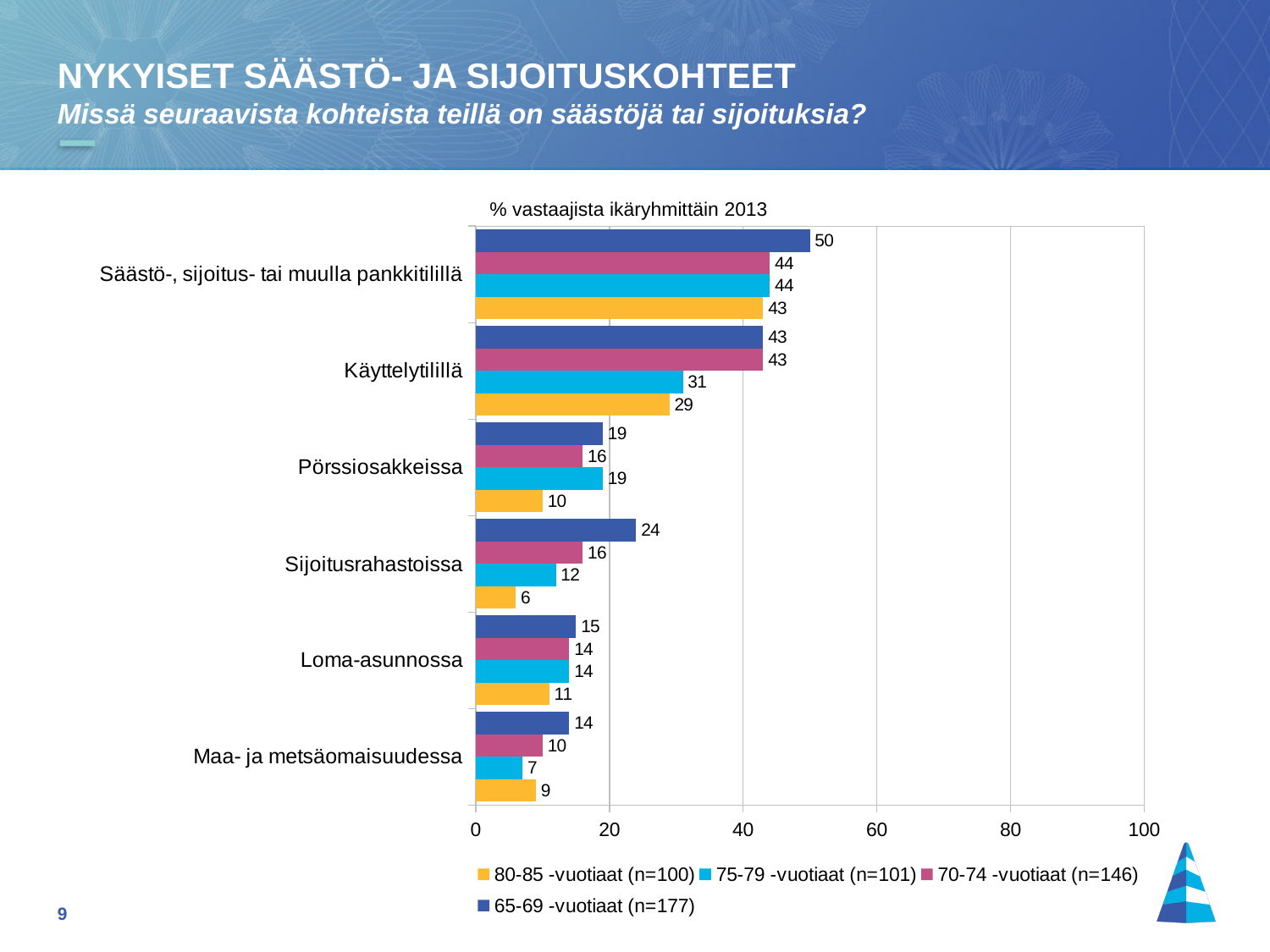
In the category Käyttelytilillä, which is larger: the value for 75-79 -vuotiaat or for 80-85 -vuotiaat? 75-79 -vuotiaat What is the difference between the 65-69 -vuotiaat and 80-85 -vuotiaat values in the category Sijoitusrahastoissa? 18 What is the value for 70-74 -vuotiaat in the category Maa- ja metsäomaisuudessa? 10 Which category has the highest value for 65-69 -vuotiaat? Säästö-, sijoitus- tai muulla pankkitilillä What is the value for 65-69 -vuotiaat in the category Säästö-, sijoitus- tai muulla pankkitilillä? 50 What is the value for 75-79 -vuotiaat in the category Sijoitusrahastoissa? 12 What kind of chart is shown on the slide? bar chart How many series does the legend list? 4 How many categories are shown on the chart? 6 Is the value for 65-69 -vuotiaat in the category Pörssiosakkeissa greater or less than 20? less What is the value for 80-85 -vuotiaat in the category Käyttelytilillä? 29 Which category has the lowest value for 80-85 -vuotiaat? Sijoitusrahastoissa